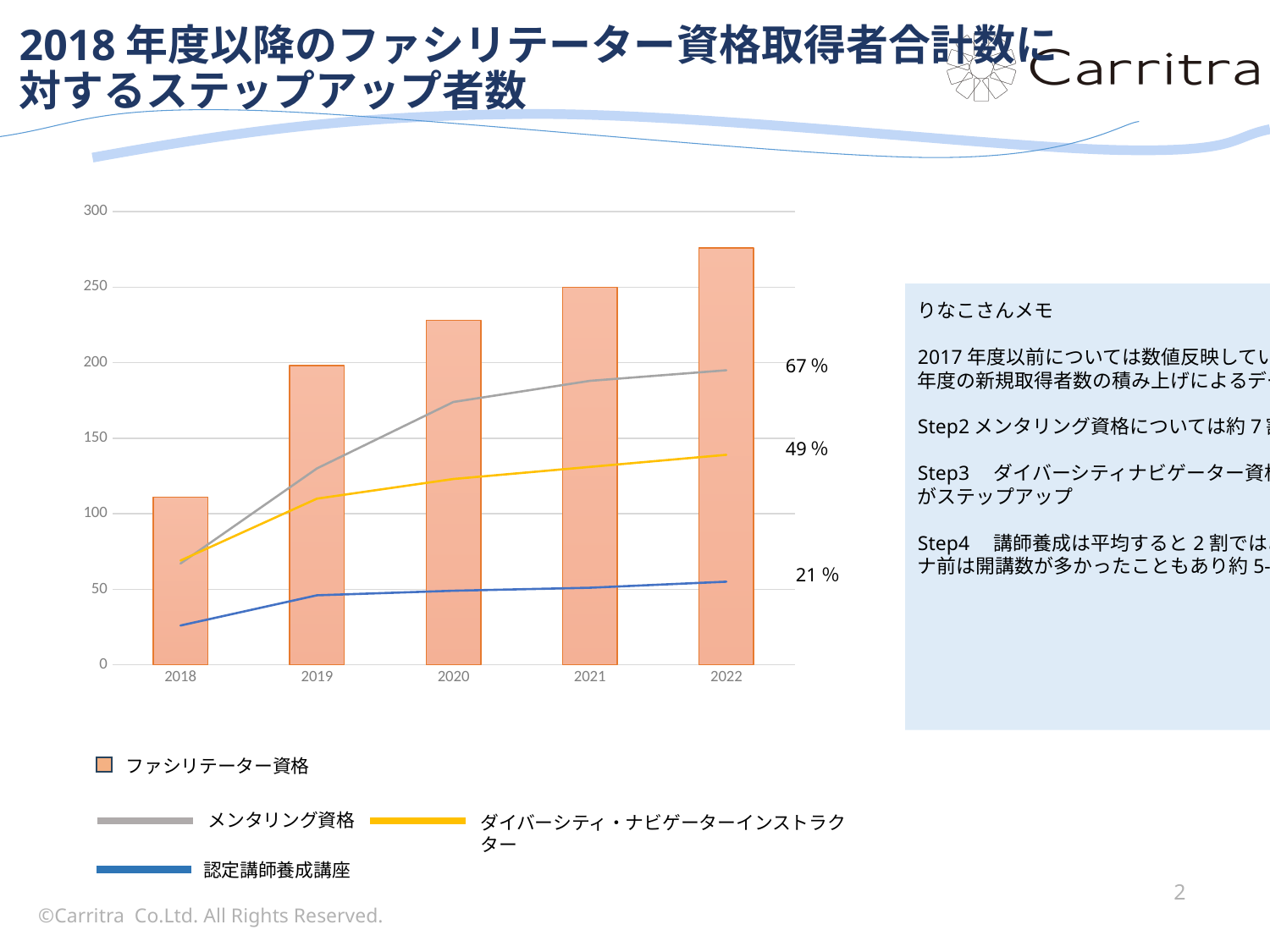
How many years are shown on the x axis of the chart? 5 Is the 認定講師養成講座 line in 2022 greater or less than 100? less Which is larger, the ファシリテーター資格 bar for 2019 or for 2020? 2020 What percentage label is shown at the end of the ダイバーシティ・ナビゲーターインストラクター (yellow) line? 49 % In which year is the ファシリテーター資格 bar the highest? 2022 Which line series is the highest in 2022? メンタリング資格 Do the ファシリテーター資格 bars rise or fall from 2018 to 2022? Rise How many series does the chart's legend list? 4 What kind of chart is shown on the slide? A combination bar and line chart Is the ファシリテーター資格 bar for 2022 greater or less than 250? greater Is the ファシリテーター資格 bar for 2018 greater or less than 150? less In which year is the ファシリテーター資格 bar the lowest? 2018